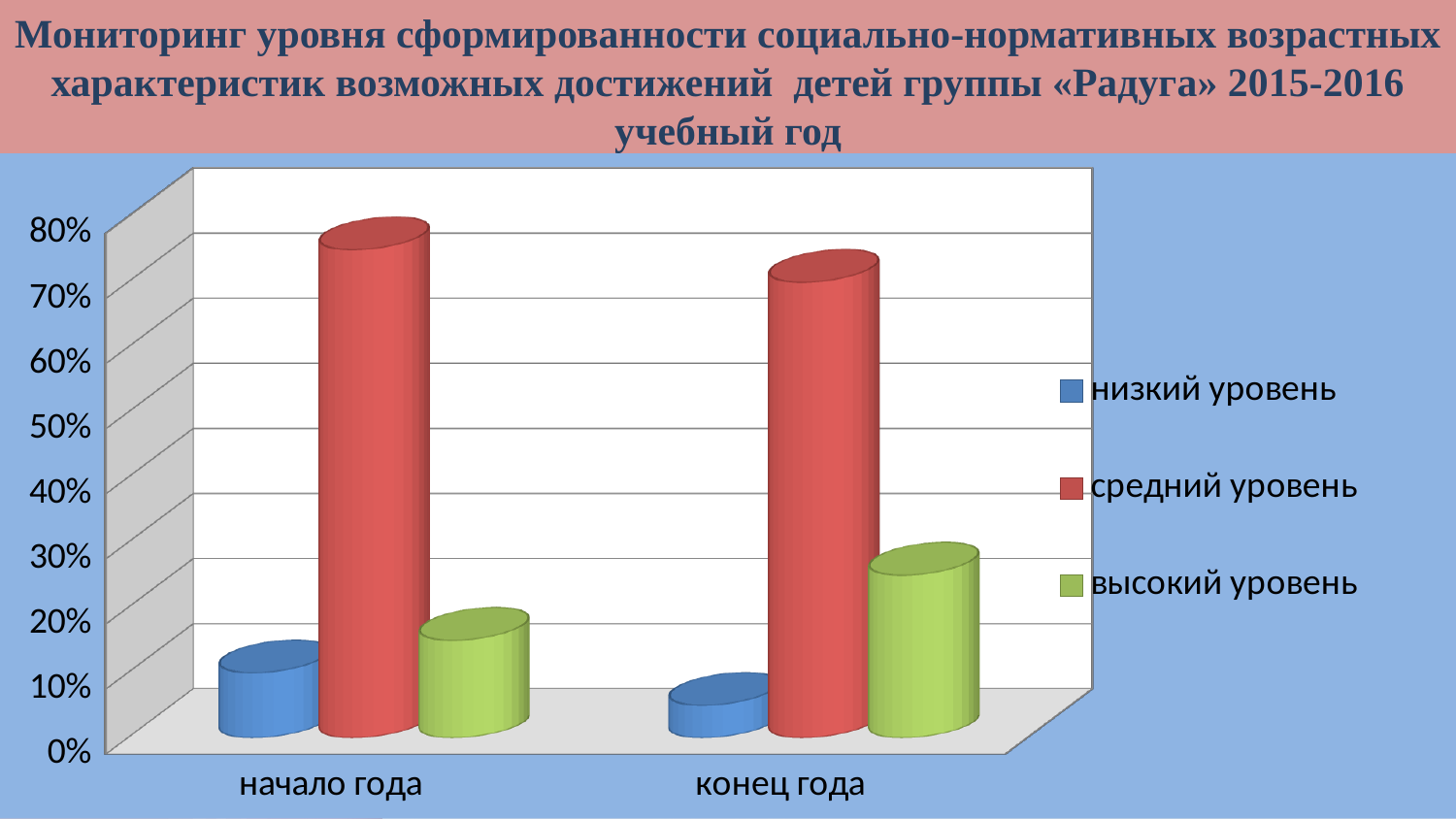
Which series has the lowest value for конец года? низкий уровень Is the value for высокий уровень at конец года greater or less than 40%? less Is the value for средний уровень at начало года greater or less than 60%? greater What colour represents средний уровень in the chart's legend? red Does the value for высокий уровень rise or fall from начало года to конец года? rise How many series does the chart's legend list? 3 Which is larger for высокий уровень: the value at начало года or at конец года? конец года How many categories are shown on the x axis of the chart? 2 Which is larger for низкий уровень: the value at начало года or at конец года? начало года Which series has the highest value for начало года? средний уровень What kind of chart is shown on the slide? bar chart Is the value for низкий уровень at конец года greater or less than 20%? less